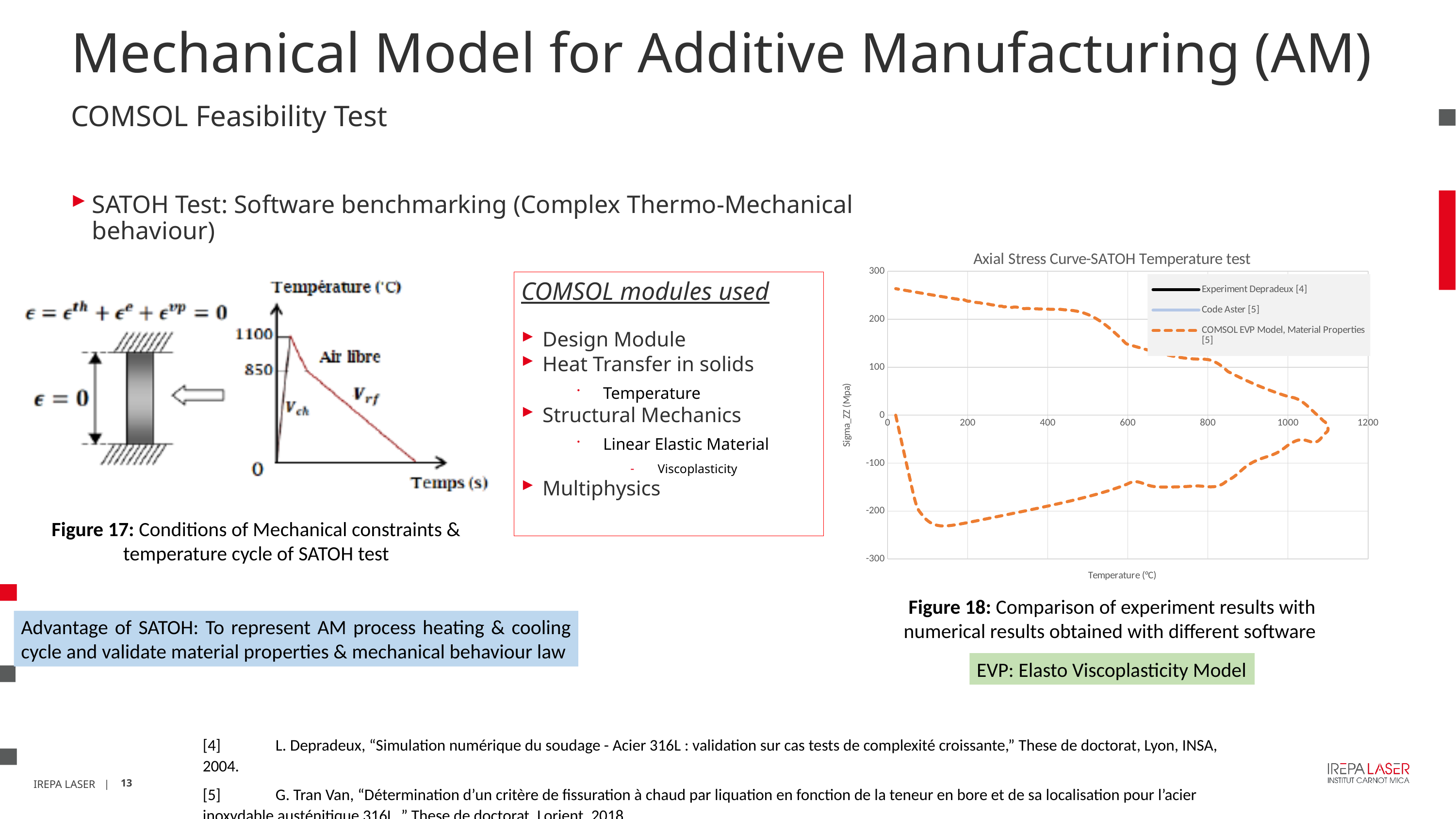
How many tick labels are shown on the x axis of the "Axial Stress Curve-SATOH Temperature test" chart? 7 In the "Axial Stress Curve-SATOH Temperature test" chart, what is the label of the x axis? Temperature (°C) What type of chart is "Axial Stress Curve-SATOH Temperature test"? Line chart How many series does the legend of the "Axial Stress Curve-SATOH Temperature test" chart list? 3 In the "Axial Stress Curve-SATOH Temperature test" chart, does the upper branch of the COMSOL EVP Model curve rise or fall as temperature increases from 0 to 1000 °C? fall In the "Axial Stress Curve-SATOH Temperature test" chart, is the lowest value reached by the COMSOL EVP Model curve greater or less than -300? greater In the "Axial Stress Curve-SATOH Temperature test" chart, is the highest value reached by the COMSOL EVP Model curve greater or less than 200? greater What is the maximum value shown on the y axis of the "Axial Stress Curve-SATOH Temperature test" chart? 300 In the "Axial Stress Curve-SATOH Temperature test" chart, is the lowest value reached by the COMSOL EVP Model curve greater or less than -200? less In the "Axial Stress Curve-SATOH Temperature test" chart, does the COMSOL EVP Model curve rise or fall between 0 and 100 °C on its lower branch? fall What is the maximum value shown on the x axis of the "Axial Stress Curve-SATOH Temperature test" chart? 1200 What is the title of the chart on the right side of the slide? Axial Stress Curve-SATOH Temperature test